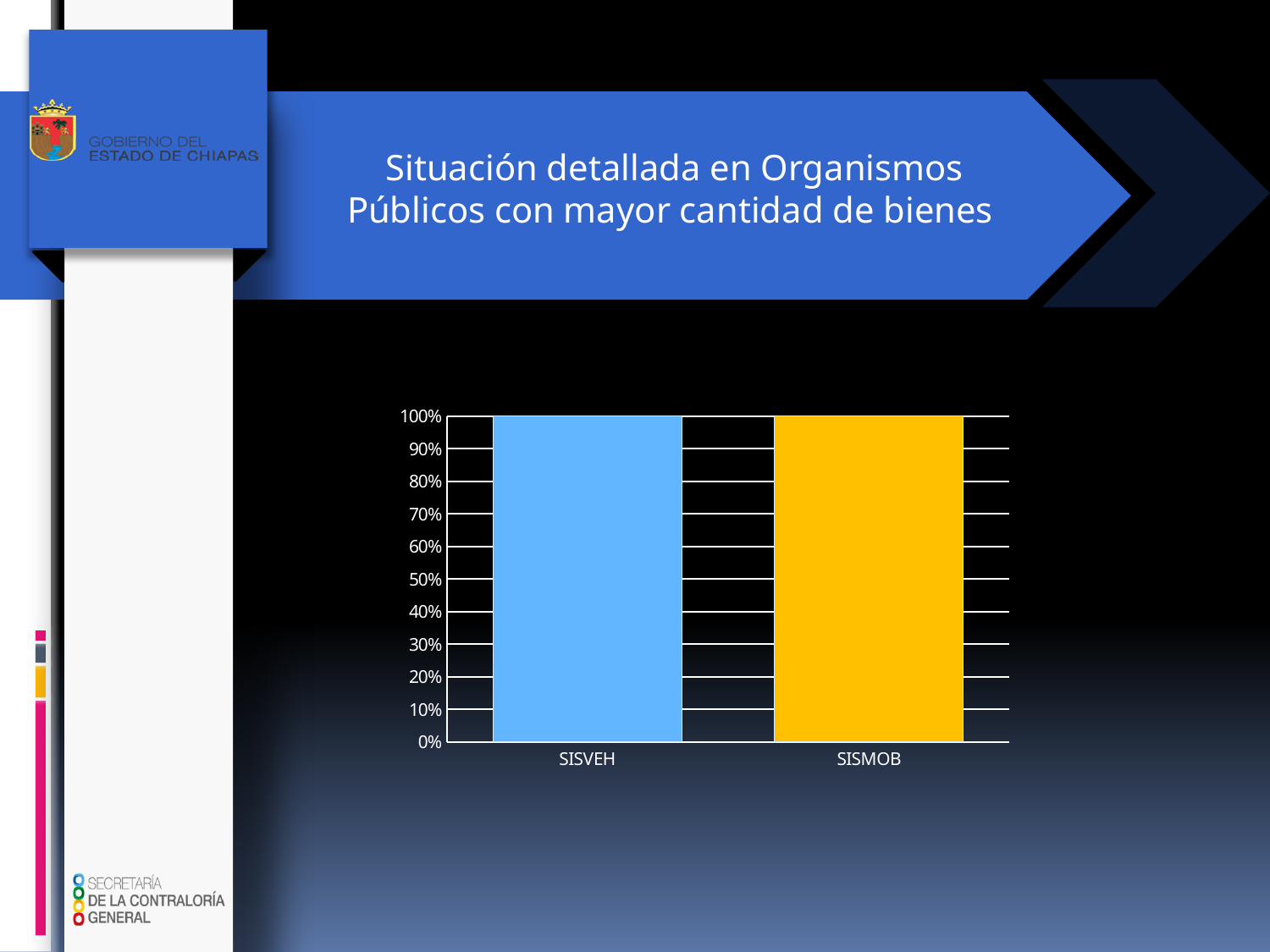
What value does the bar for SISMOB reach on the y axis? 100% Is the value for SISMOB greater or less than 90%? greater What is the difference between the values for SISVEH and SISMOB? 0% Is the value for SISVEH greater or less than 50%? greater How many categories are shown on the x axis of the chart? 2 Which category is labelled on the left of the x axis? SISVEH What value does the bar for SISVEH reach on the y axis? 100% What colour is the bar for SISMOB? yellow What is the highest value shown on the y axis of the chart? 100% What kind of chart is shown on the slide? bar chart